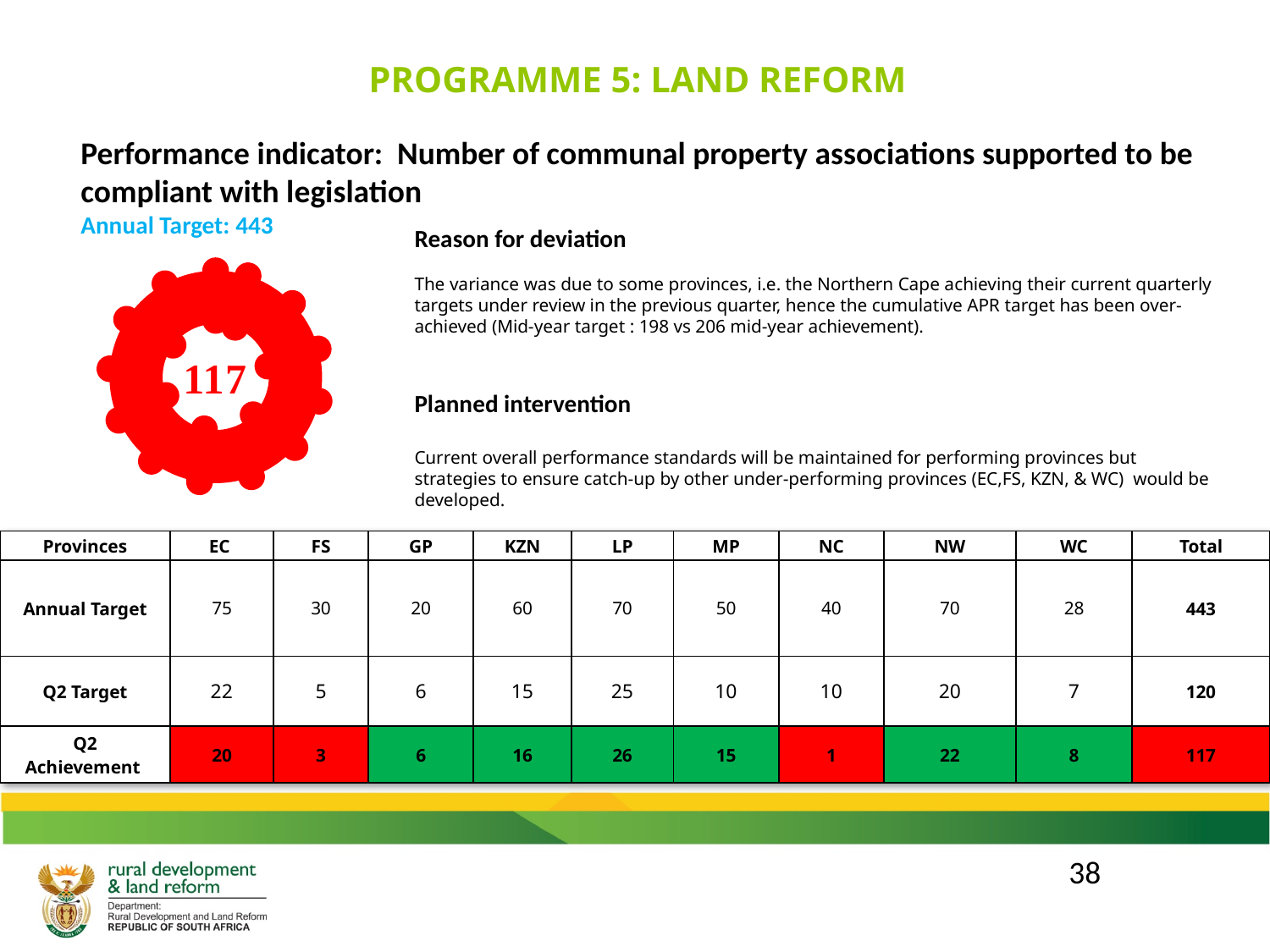
What kind of chart is shown on the left of the slide? Doughnut chart What value is printed in the centre of the doughnut chart? 117 What colour is the doughnut chart? Red Is the value shown in the centre of the doughnut chart greater or less than 100? greater